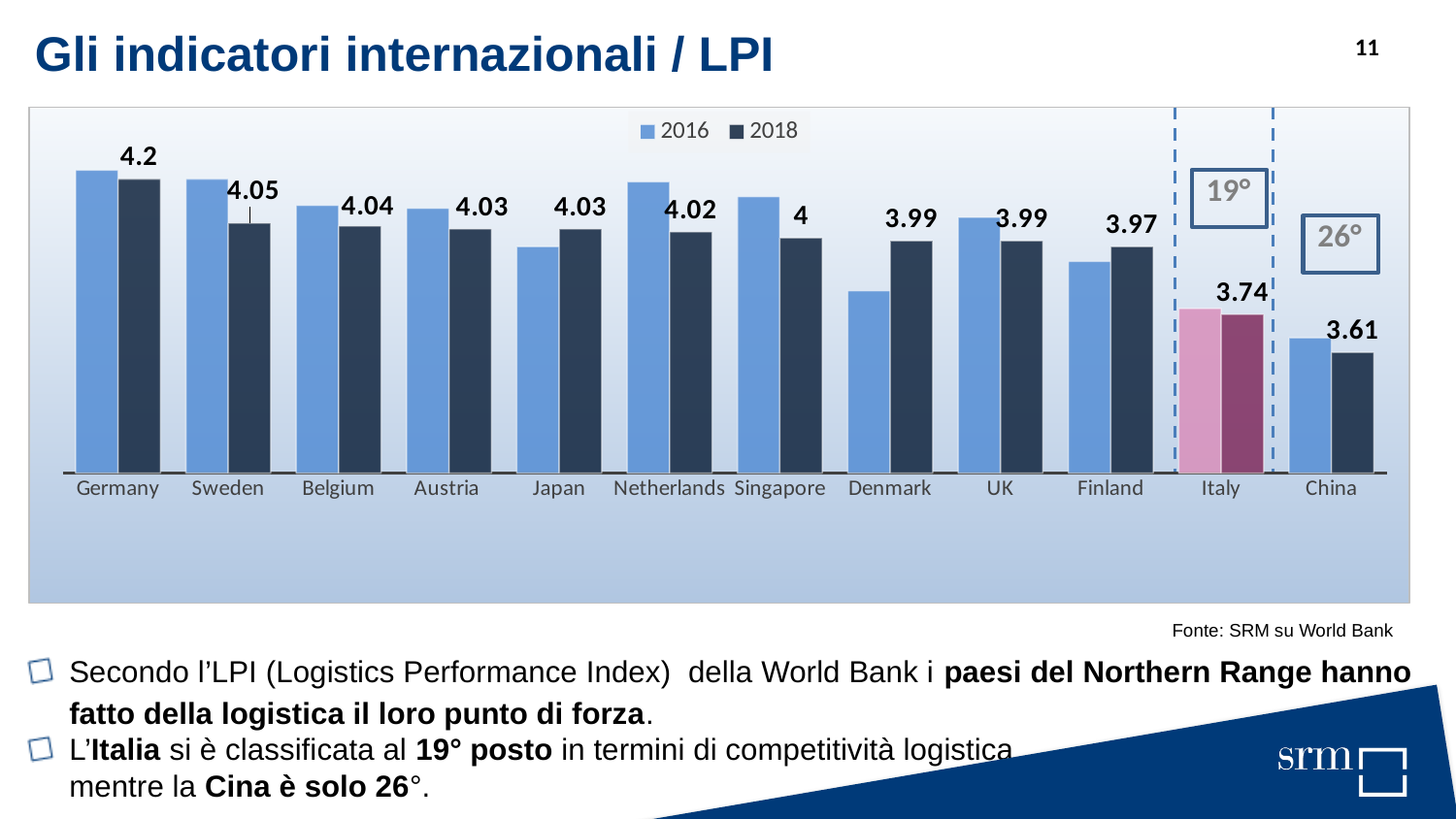
How many series does the legend list? 2 Which country has the lowest 2018 LPI value? China Which has a higher 2018 LPI value, Sweden or Finland? Sweden What kind of chart is shown on the slide? Bar chart What is the 2018 LPI value for Finland? 3.97 What is the 2018 LPI value for Germany? 4.2 What is the 2018 LPI value for Italy? 3.74 What is the 2018 LPI value for China? 3.61 What is the difference between the 2018 LPI values of Germany and China? 0.59 How many countries are shown on the chart? 12 What is the difference between the 2018 LPI values of Italy and China? 0.13 Which country has the highest 2018 LPI value? Germany